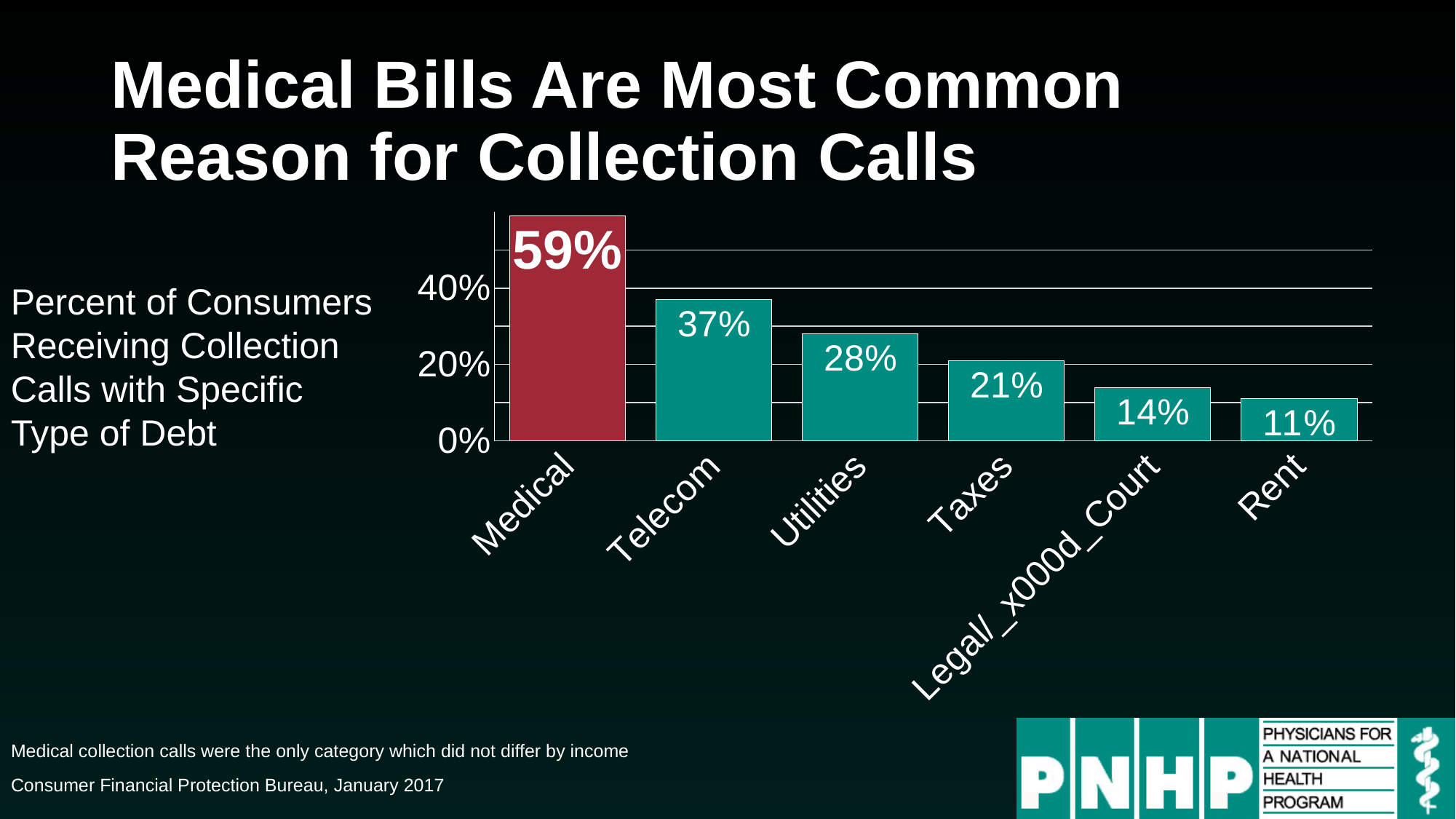
What percent of consumers received collection calls for medical debt? 59% Which is larger, the value for Utilities or the value for Taxes? Utilities What is the difference in percentage points between Taxes and Rent? 10 What is the difference in percentage points between Medical and Telecom? 22 Which type of debt has the lowest percentage of consumers receiving collection calls? Rent Which type of debt has the highest percentage of consumers receiving collection calls? Medical What kind of chart is shown on the slide? Bar chart How many types of debt are shown in the chart? 6 What is the value shown for Utilities? 28% What is the value shown for Telecom? 37% What is the value shown for Rent? 11% Which bar is shown in a different colour (red) from the others? Medical